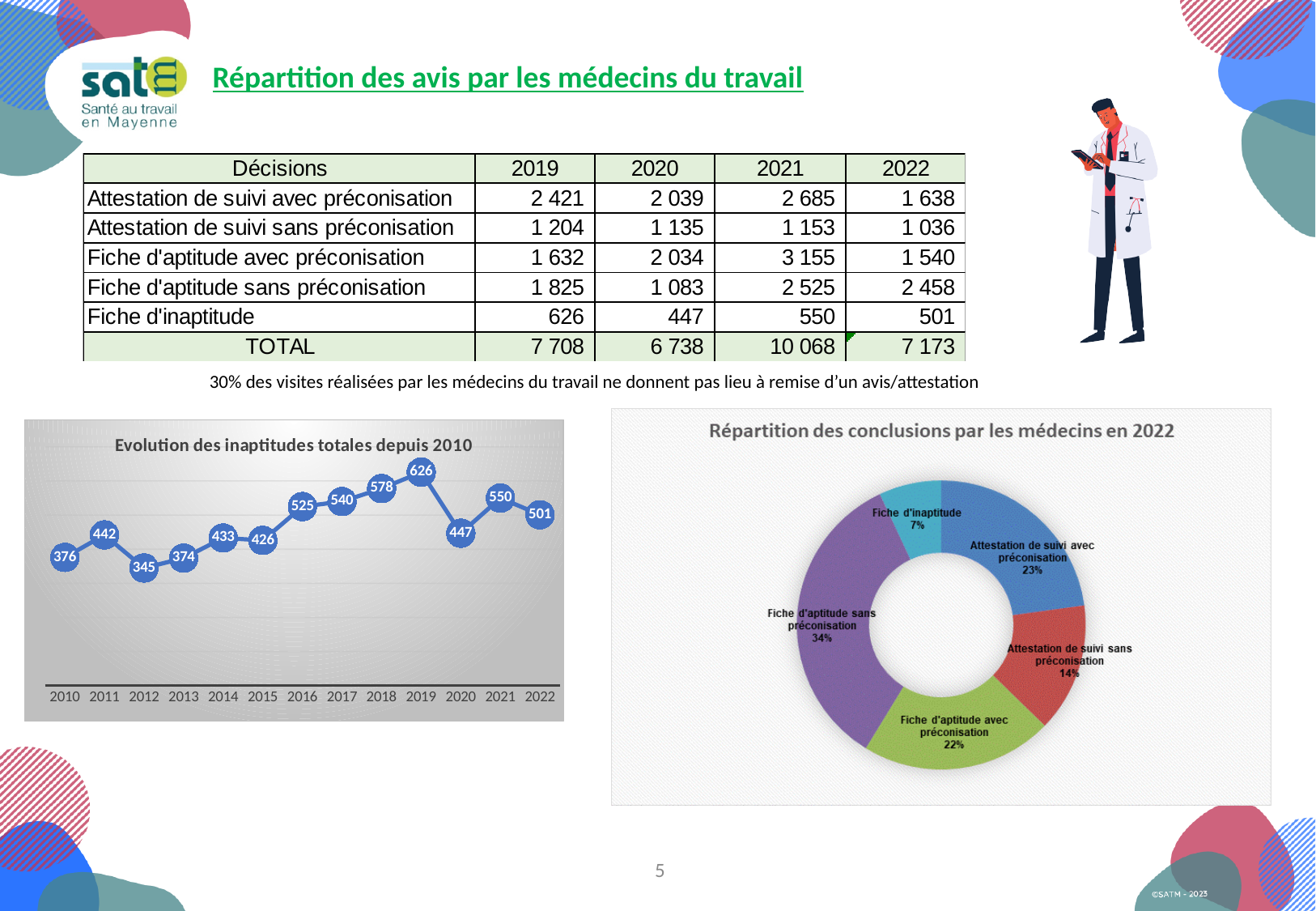
In the chart 'Répartition des conclusions par les médecins en 2022', which category has the smallest share? Fiche d'inaptitude In the chart 'Evolution des inaptitudes totales depuis 2010', what is the value for 2019? 626 In the chart 'Evolution des inaptitudes totales depuis 2010', which year has the highest value? 2019 In the chart 'Evolution des inaptitudes totales depuis 2010', what is the value for 2012? 345 In the chart 'Evolution des inaptitudes totales depuis 2010', how many years are plotted? 13 In the chart 'Evolution des inaptitudes totales depuis 2010', which is larger, the value for 2021 or the value for 2022? 2021 In the chart 'Evolution des inaptitudes totales depuis 2010', do the values rise or fall from 2015 to 2019? Rise In the chart 'Evolution des inaptitudes totales depuis 2010', what is the difference between the values for 2019 and 2020? 179 In the chart 'Répartition des conclusions par les médecins en 2022', what share does 'Fiche d'aptitude sans préconisation' have? 34% What kind of chart is 'Evolution des inaptitudes totales depuis 2010'? Line chart In the chart 'Evolution des inaptitudes totales depuis 2010', which year has the lowest value? 2012 In the chart 'Répartition des conclusions par les médecins en 2022', how many categories are shown? 5